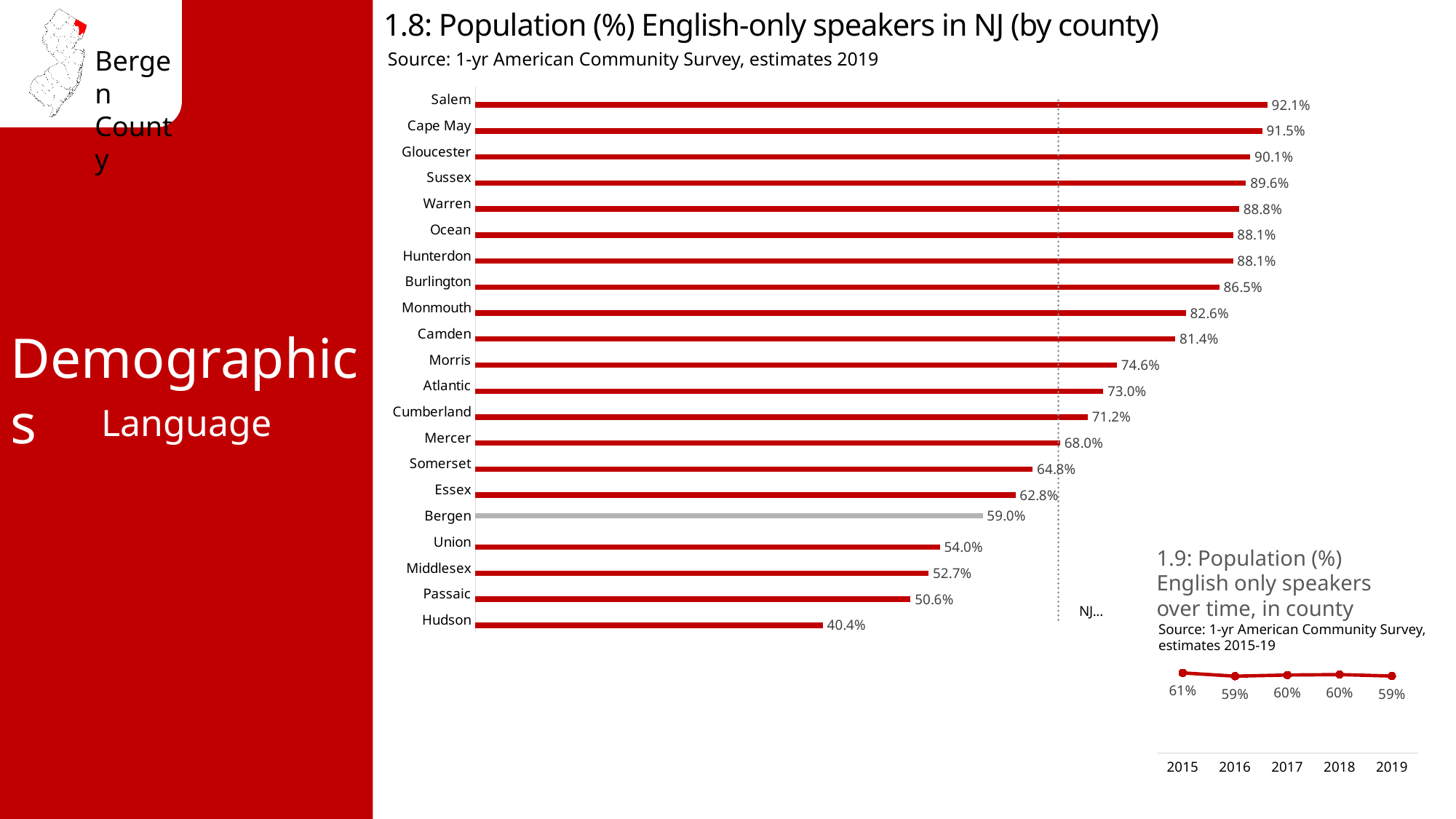
What kind of chart is chart 1.9? Line chart In chart 1.8, what is the value for Bergen? 59.0% What kind of chart is chart 1.8? Bar chart In chart 1.8, which county has the lowest percentage of English-only speakers? Hudson In chart 1.8, what is the value for Hudson? 40.4% In chart 1.9, how many years are plotted? 5 In chart 1.9, what is the value for 2015? 61% In chart 1.8, which has a larger value, Morris or Mercer? Morris In chart 1.8, how many counties are plotted? 21 In chart 1.8, what is the difference between the values for Salem and Hudson? 51.7% In chart 1.8, which county's bar is shown in grey instead of red? Bergen In chart 1.8, which county has the highest percentage of English-only speakers? Salem